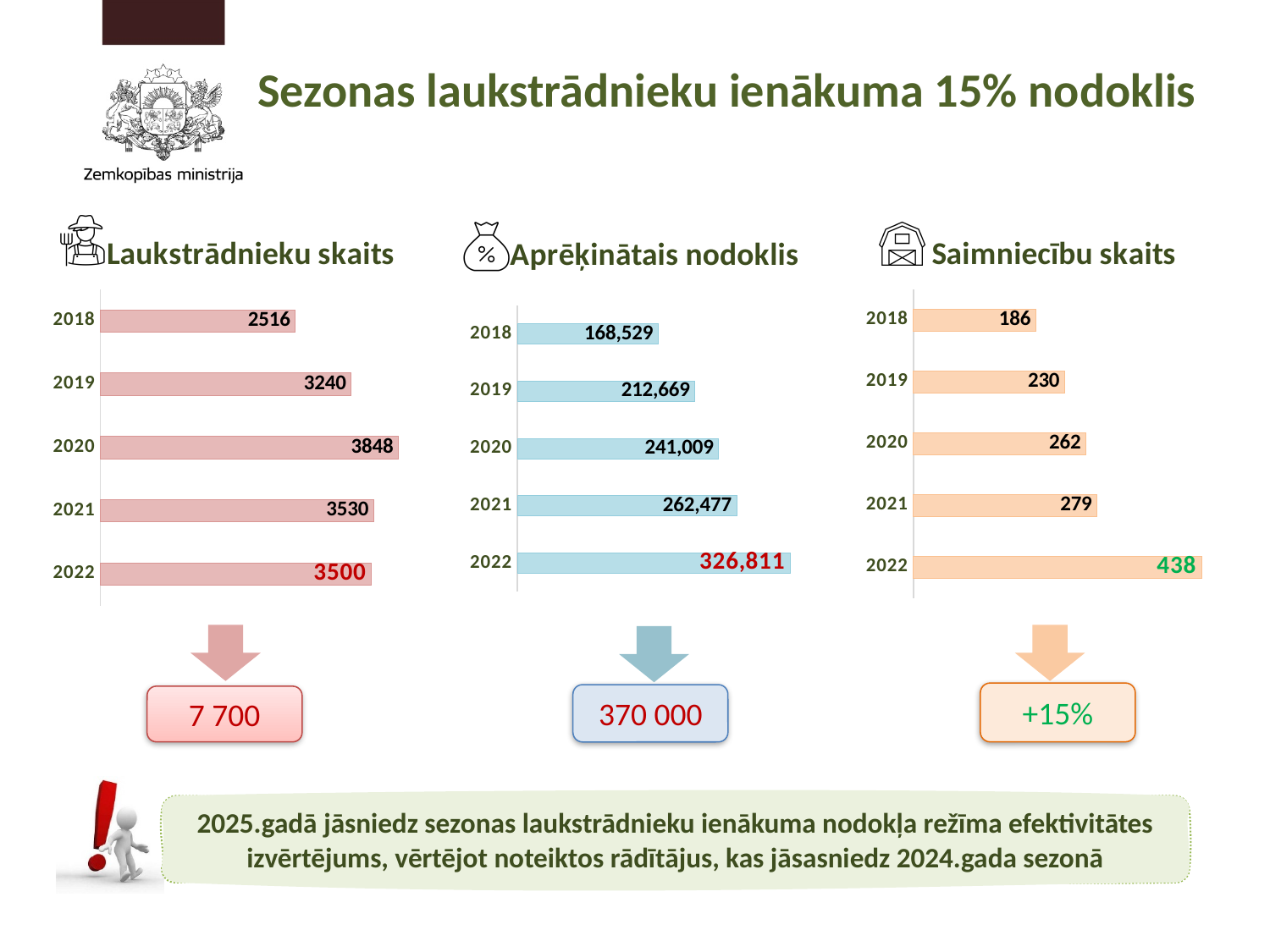
In the 'Saimniecību skaits' chart, which is larger, the value for 2021 or the value for 2022? 2022 In the 'Laukstrādnieku skaits' chart, what is the difference between the values for 2019 and 2018? 724 In the 'Saimniecību skaits' chart, what is the difference between the values for 2022 and 2021? 159 In the 'Aprēķinātais nodoklis' chart, what is the value for 2022? 326,811 In the 'Laukstrādnieku skaits' chart, how many years are shown? 5 In the 'Laukstrādnieku skaits' chart, what is the value for 2020? 3848 What type of chart is the 'Saimniecību skaits' chart? bar chart In the 'Aprēķinātais nodoklis' chart, which year has the highest value? 2022 In the 'Aprēķinātais nodoklis' chart, do the values rise or fall from 2018 to 2022? rise In the 'Laukstrādnieku skaits' chart, which year has the lowest value? 2018 In the 'Aprēķinātais nodoklis' chart, what is the difference between the values for 2021 and 2020? 21,468 In the 'Saimniecību skaits' chart, what is the value for 2019? 230